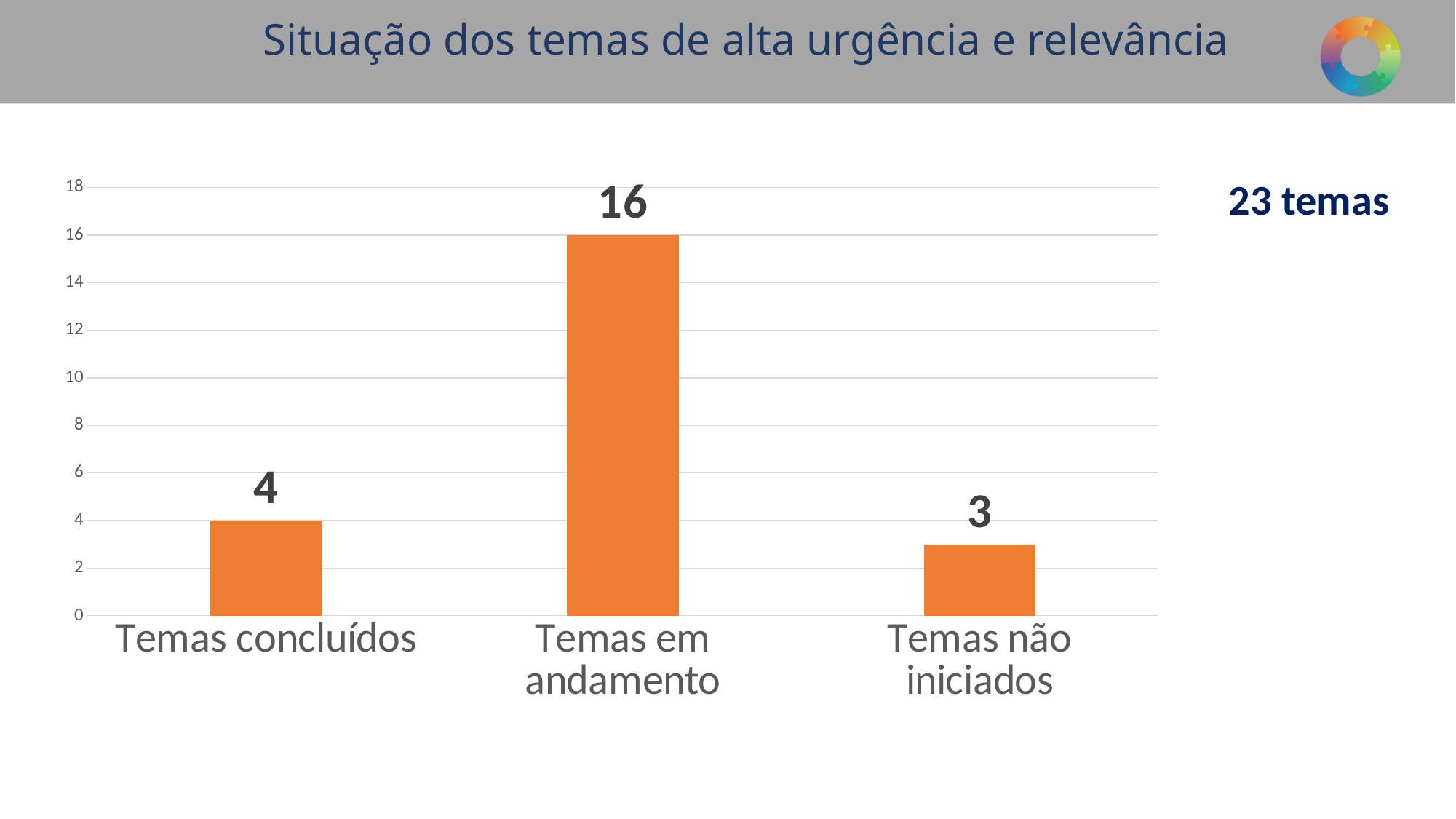
How many categories are shown on the chart? 3 What is the difference between the values for Temas concluídos and Temas não iniciados? 1 What is the value for Temas em andamento? 16 What is the difference between the values for Temas em andamento and Temas concluídos? 12 Which category has the highest value? Temas em andamento What is the value for Temas não iniciados? 3 What is the title of the slide containing the chart? Situação dos temas de alta urgência e relevância Is the value for Temas em andamento greater or less than 10? greater What is the value for Temas concluídos? 4 Which category has the lowest value? Temas não iniciados Which is larger, the value for Temas concluídos or the value for Temas não iniciados? Temas concluídos What kind of chart is shown on the slide? bar chart